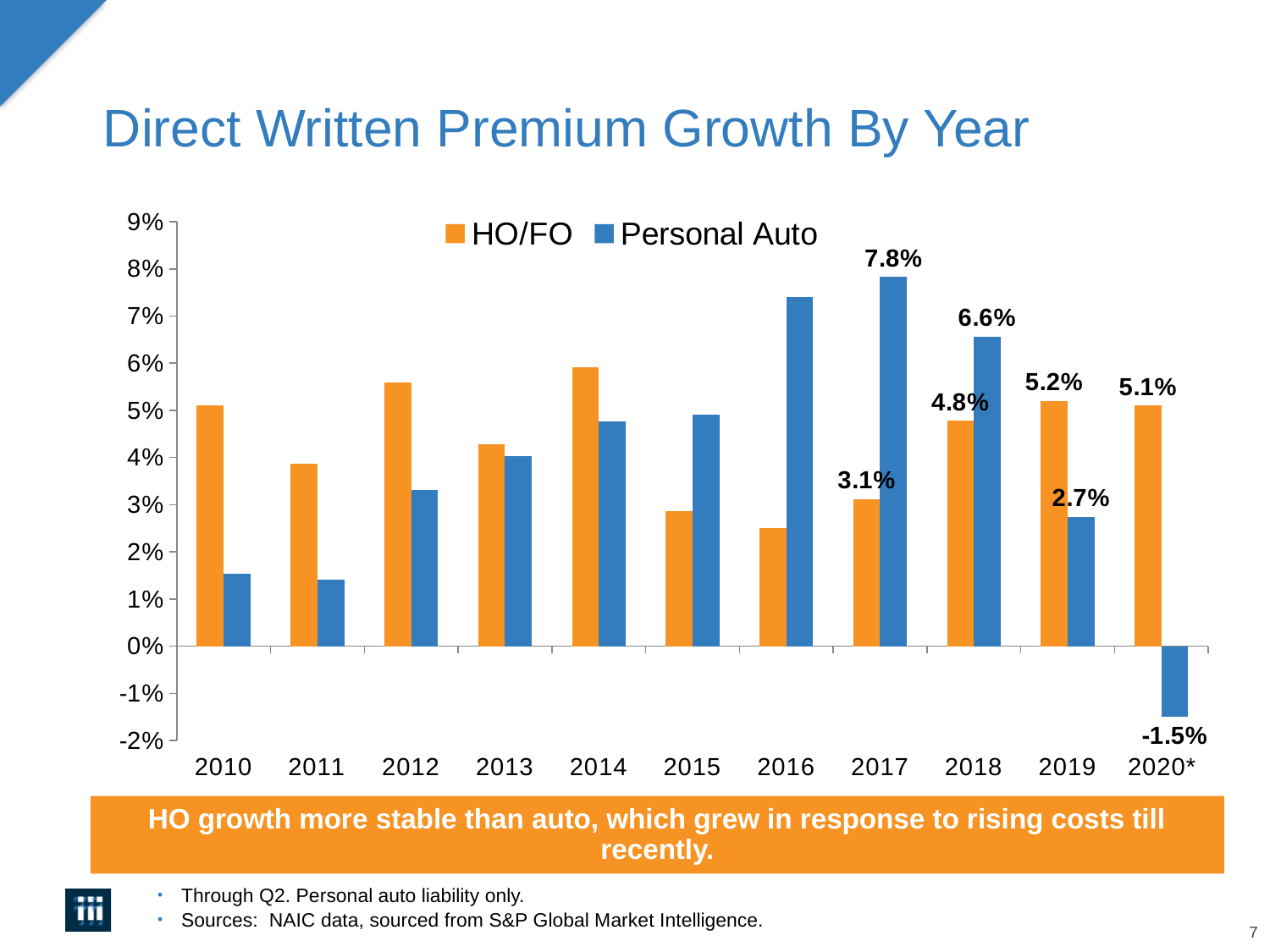
What is the Personal Auto growth value shown for 2018? 6.6% What is the difference between Personal Auto and HO/FO growth in 2017? 4.7 percentage points In which year does Personal Auto growth reach its lowest value? 2020* In which year is the Personal Auto growth highest? 2017 Is the Personal Auto value for 2016 greater or less than 7%? greater Is the Personal Auto value for 2010 greater or less than 2%? less What is the Personal Auto growth value for 2020*? -1.5% In 2019, which series has the larger growth value, HO/FO or Personal Auto? HO/FO How many years are shown on the x axis? 11 What is the HO/FO growth value for 2019? 5.2% How many series does the legend list? 2 What is the HO/FO direct written premium growth for 2017? 3.1%